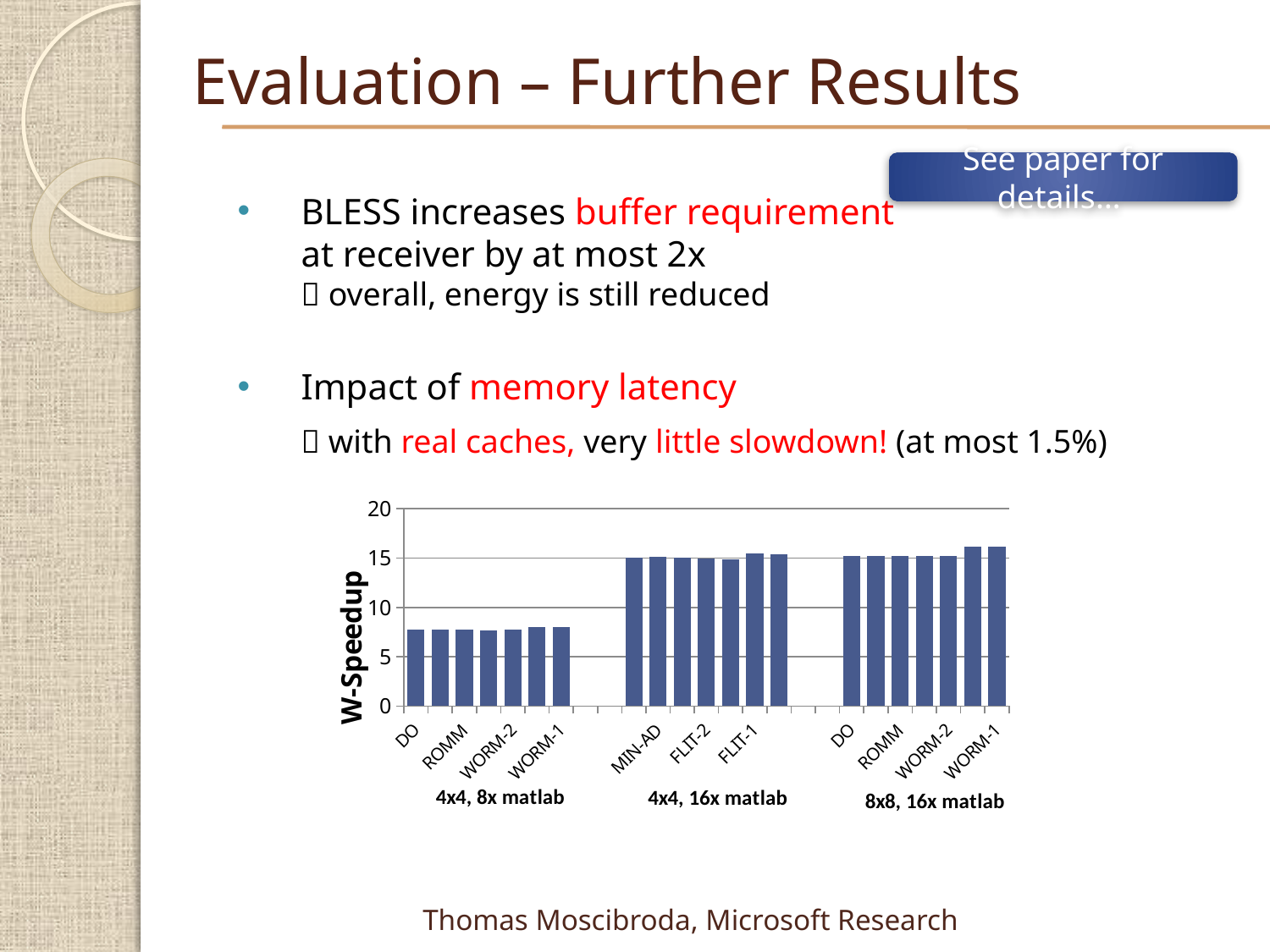
How many configuration groups are shown along the x axis of the chart? 3 Is the W-Speedup value for WORM-1 in the "8x8, 16x matlab" group greater or less than 10? greater How many bars are in the "4x4, 8x matlab" group of the chart? 7 Which has the larger W-Speedup: DO in the "4x4, 8x matlab" group or DO in the "8x8, 16x matlab" group? DO in the 8x8, 16x matlab group Is the W-Speedup value for WORM-1 in the "4x4, 8x matlab" group greater or less than 5? greater What kind of chart is shown on the slide? bar chart What is the label on the y axis of the chart? W-Speedup What is the highest tick value shown on the y axis of the chart? 20 Is the W-Speedup value for MIN-AD in the "4x4, 16x matlab" group greater or less than 10? greater Which group of bars has the lowest W-Speedup values in the chart? 4x4, 8x matlab